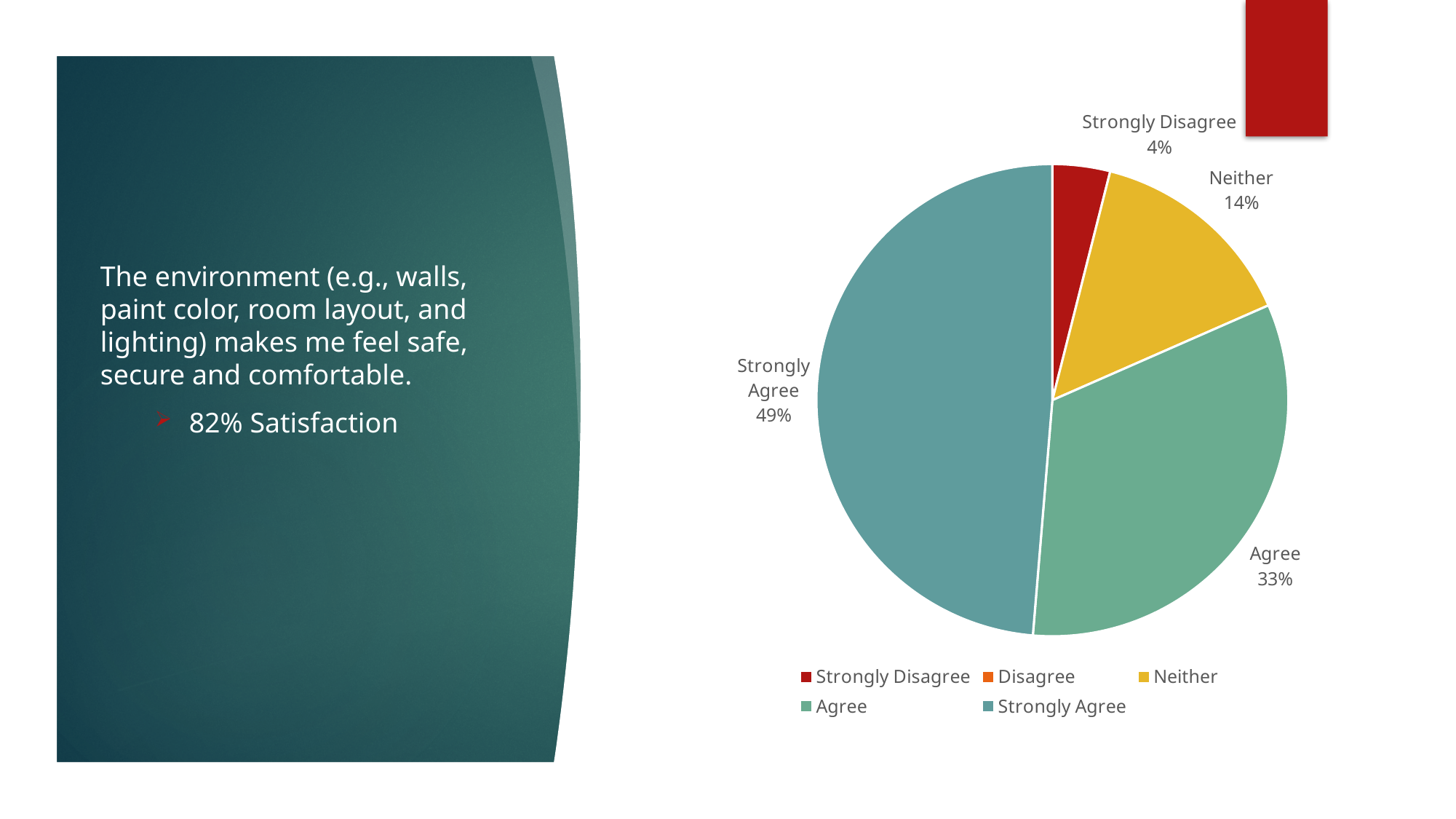
What percentage of respondents answered Strongly Agree? 49% What percentage of respondents answered Agree? 33% Which response category has the largest share of the pie? Strongly Agree What percentage of respondents answered Neither? 14% What is the difference in percentage points between Strongly Agree and Agree? 16 What is the combined share of Strongly Agree and Agree? 82% Which labelled slice has the smallest share of the pie? Strongly Disagree How many entries does the legend list? 5 What kind of chart is shown on the slide? pie chart What colour is the Neither slice? yellow What percentage of respondents answered Strongly Disagree? 4% Which is larger, the Neither slice or the Strongly Disagree slice? Neither